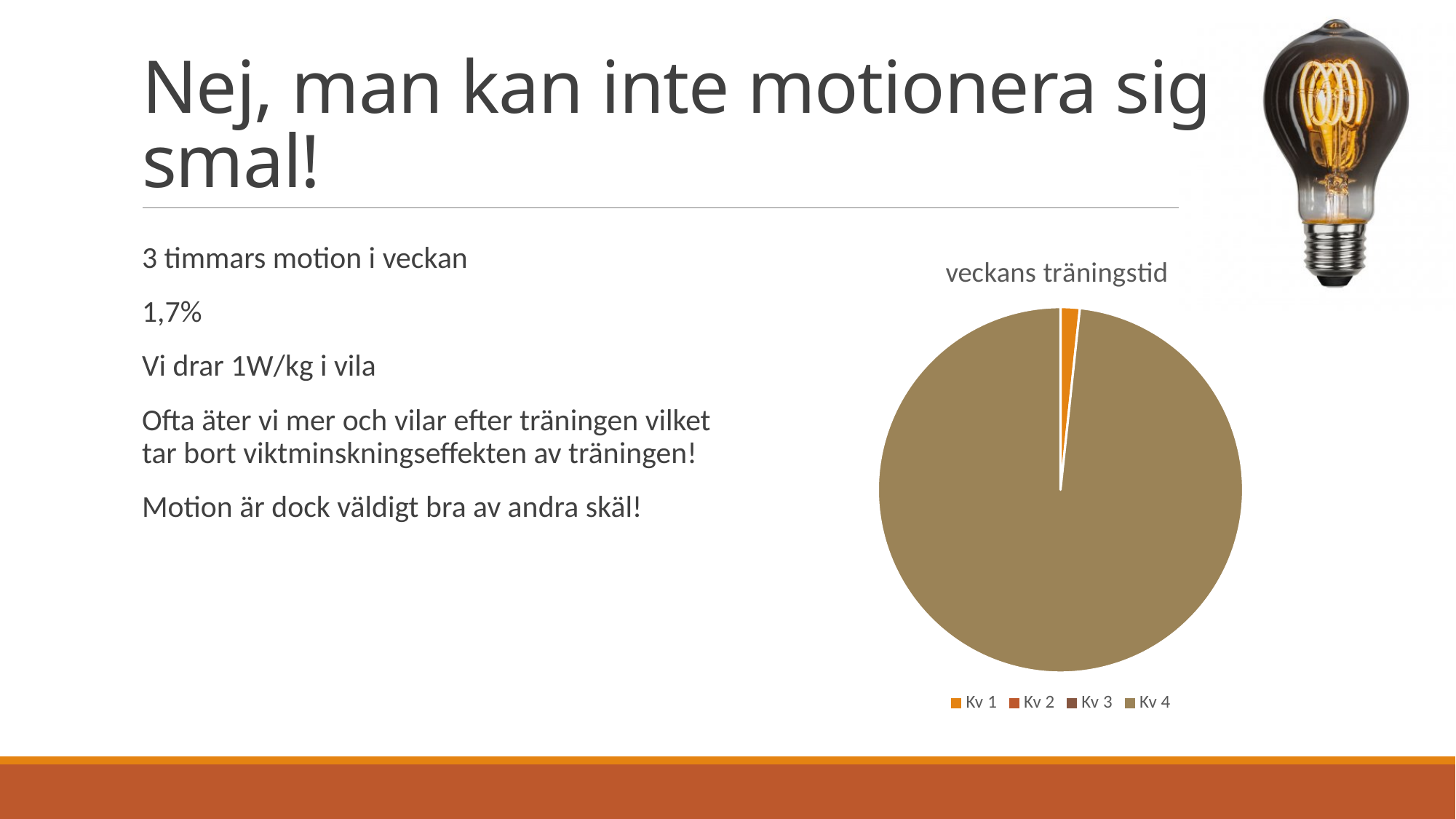
What is the title of the pie chart? veckans träningstid What are the legend entries of the pie chart, in order? Kv 1, Kv 2, Kv 3, Kv 4 Does the Kv 4 slice take up more or less than half of the pie chart? more Does the Kv 1 slice take up more or less than half of the pie chart? less How many entries does the legend of the pie chart list? 4 Which category has the largest slice in the pie chart? Kv 4 What kind of chart is shown on the slide? pie chart Which slice is larger in the pie chart, Kv 1 or Kv 4? Kv 4